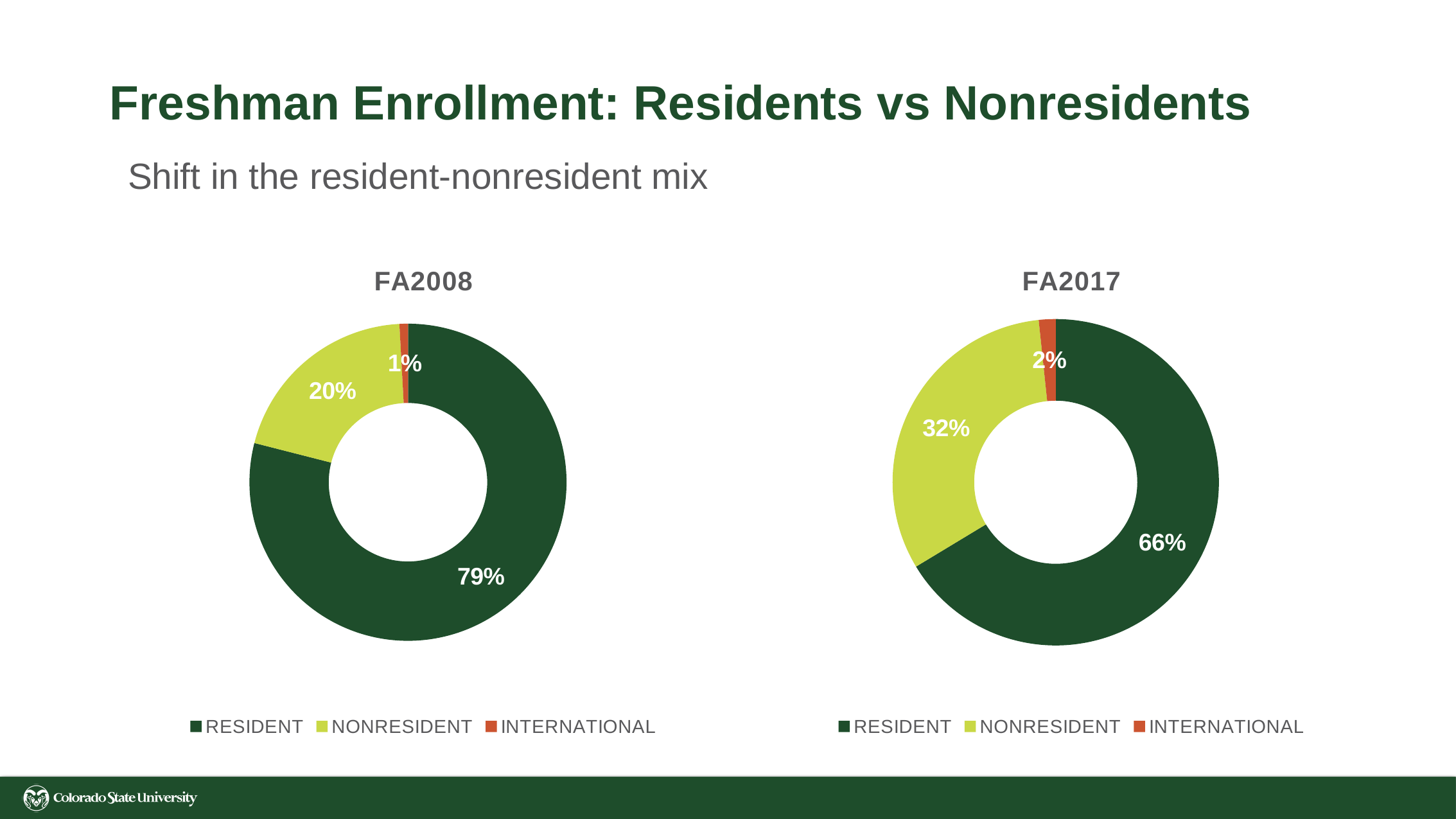
In the FA2017 chart, what share is RESIDENT? 66% In the FA2008 chart, what share of freshman enrollment is RESIDENT? 79% In the FA2008 chart, what share is INTERNATIONAL? 1% What colour represents INTERNATIONAL in the legend of the FA2008 chart? Orange Which is larger: the RESIDENT share in the FA2008 chart or the RESIDENT share in the FA2017 chart? FA2008 How many categories does the FA2017 chart show? 3 What is the difference between the NONRESIDENT share in the FA2017 chart and the NONRESIDENT share in the FA2008 chart? 12% In the FA2008 chart, which category has the largest share? RESIDENT In the FA2017 chart, which category has the smallest share? INTERNATIONAL In the FA2017 chart, what is the combined share of NONRESIDENT and INTERNATIONAL? 34% In the FA2017 chart, what share of freshman enrollment is NONRESIDENT? 32% What kind of chart is the FA2008 chart? Doughnut (pie) chart